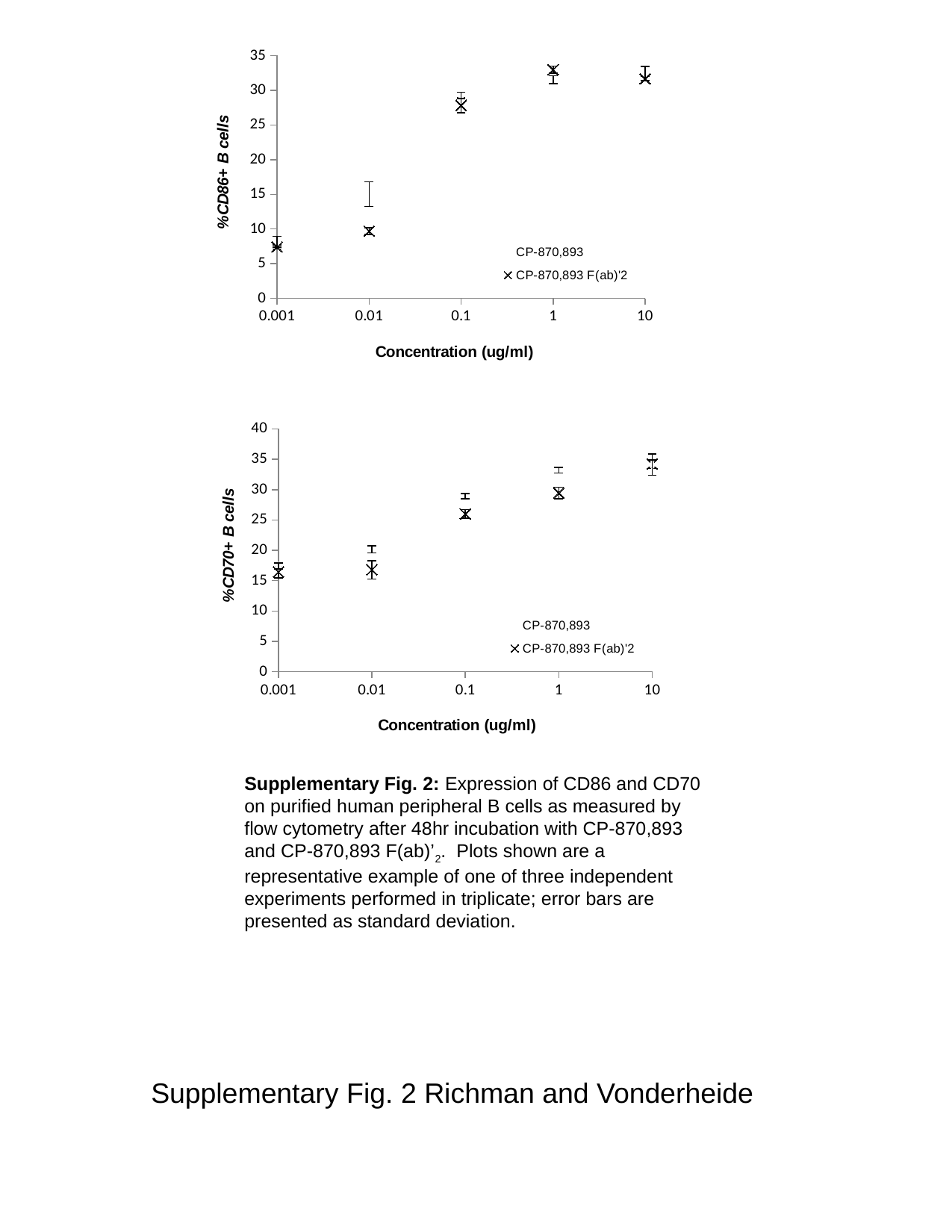
In the top chart (%CD86+ B cells), is the CP-870,893 F(ab)'2 value at 0.1 ug/ml greater or less than 20? greater In the top chart (%CD86+ B cells), at which concentration is the CP-870,893 F(ab)'2 value lowest? 0.001 What is the x-axis title of the bottom chart (%CD70+ B cells)? Concentration (ug/ml) In the top chart (%CD86+ B cells), do the CP-870,893 F(ab)'2 values generally rise or fall as concentration increases from 0.001 to 1 ug/ml? rise How many series does the legend of the top chart (%CD86+ B cells) list? 2 In the top chart (%CD86+ B cells), is the CP-870,893 F(ab)'2 value larger at 0.1 ug/ml or at 0.01 ug/ml? 0.1 In the bottom chart (%CD70+ B cells), do the CP-870,893 F(ab)'2 values rise or fall as concentration increases along the x axis? rise In the bottom chart (%CD70+ B cells), is the CP-870,893 F(ab)'2 value at 0.001 ug/ml greater or less than 10? greater What kind of chart is the top chart (%CD86+ B cells)? scatter chart with error bars How many concentration values are plotted along the x axis of the bottom chart (%CD70+ B cells)? 5 In the bottom chart (%CD70+ B cells), at which concentration is the CP-870,893 F(ab)'2 value highest? 10 In the top chart (%CD86+ B cells), is the CP-870,893 F(ab)'2 value at 0.01 ug/ml greater or less than 15? less